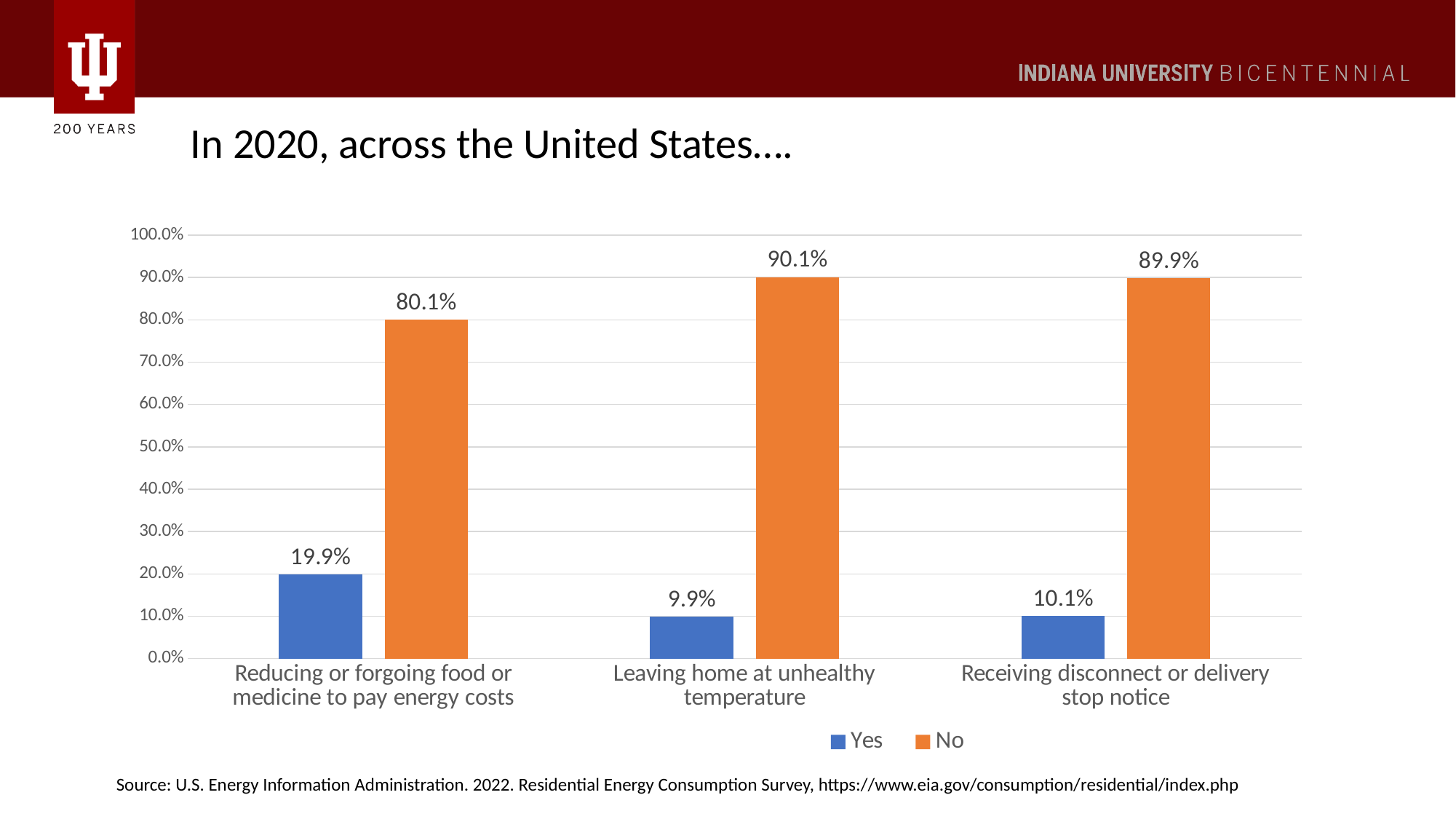
How many series does the legend list? 2 Is the 'No' value for 'Receiving disconnect or delivery stop notice' greater or less than 80.0%? greater What colour are the 'No' bars? orange Which category has the highest 'Yes' value? Reducing or forgoing food or medicine to pay energy costs What is the 'Yes' value for 'Reducing or forgoing food or medicine to pay energy costs'? 19.9% Which category has the lowest 'No' value? Reducing or forgoing food or medicine to pay energy costs What kind of chart is shown on the slide? bar chart What is the difference between the 'No' and 'Yes' values for 'Reducing or forgoing food or medicine to pay energy costs'? 60.2% Which is larger: the 'Yes' value for 'Reducing or forgoing food or medicine to pay energy costs' or the 'Yes' value for 'Leaving home at unhealthy temperature'? Reducing or forgoing food or medicine to pay energy costs How many categories are shown on the x axis? 3 What is the 'Yes' value for 'Receiving disconnect or delivery stop notice'? 10.1% What is the 'No' value for 'Leaving home at unhealthy temperature'? 90.1%